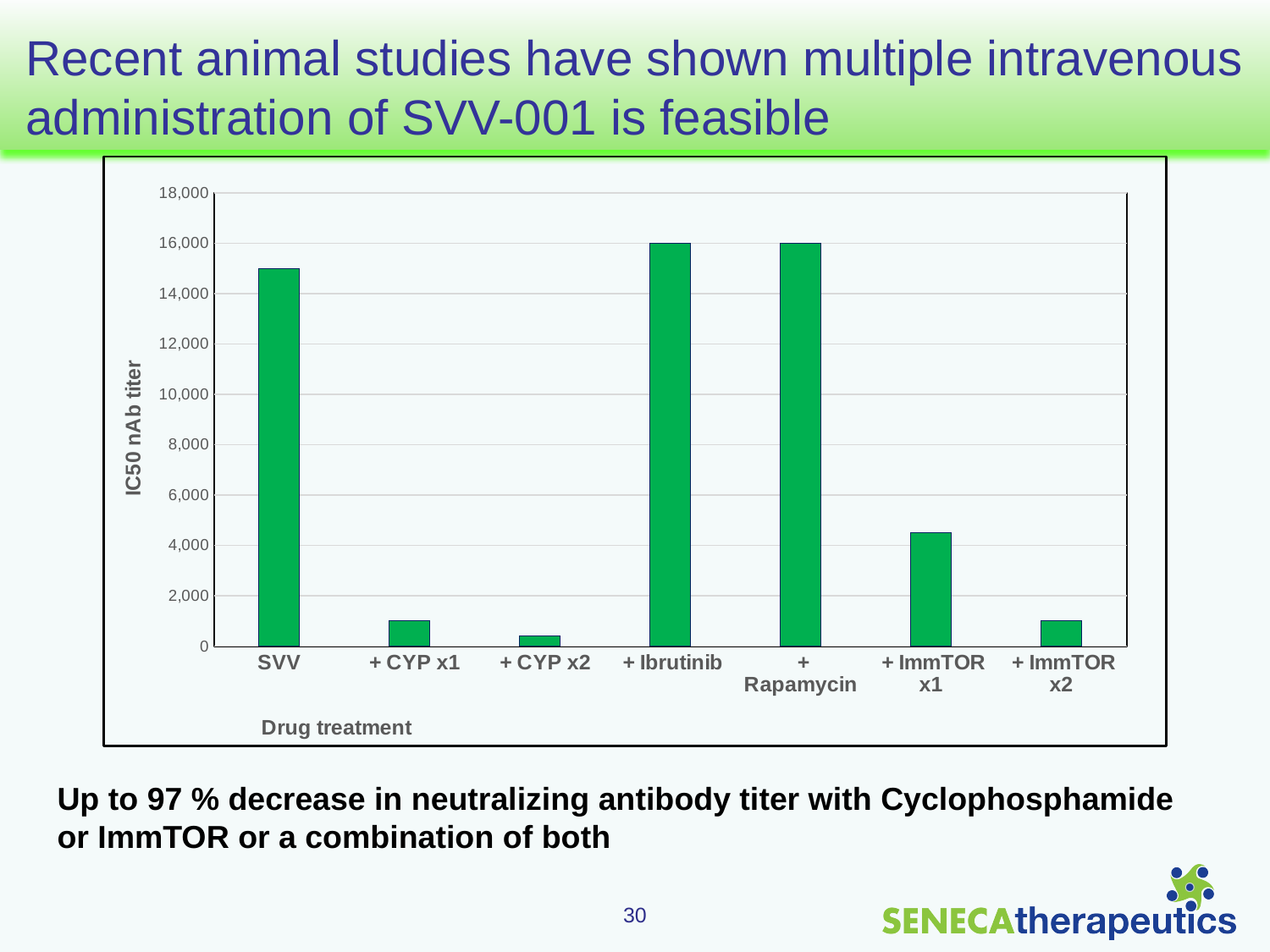
Which has a higher IC50 nAb titer, SVV or + ImmTOR x1? SVV What is the title of the horizontal axis of the chart? Drug treatment Which drug treatment has the lowest IC50 nAb titer? + CYP x2 What is the title of the vertical axis of the chart? IC50 nAb titer Is the IC50 nAb titer for + ImmTOR x2 greater or less than 2,000? less Which has a higher IC50 nAb titer, + CYP x1 or + ImmTOR x1? + ImmTOR x1 What kind of chart is shown on the slide? bar chart Is the IC50 nAb titer for + Rapamycin greater or less than 14,000? greater Is the IC50 nAb titer for + ImmTOR x1 greater or less than 4,000? greater How many drug treatment categories are plotted on the chart? 7